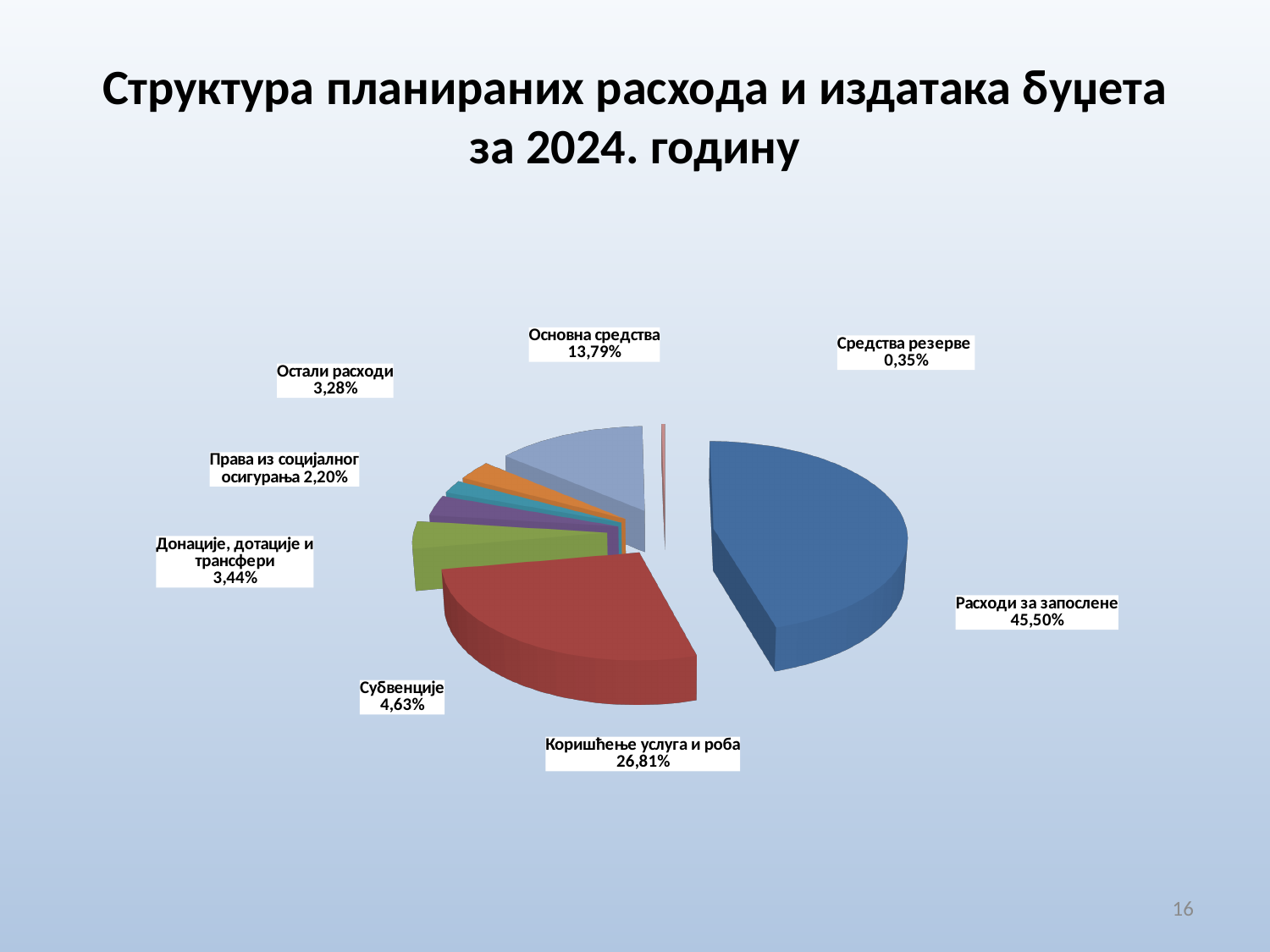
What percentage is shown for Субвенције? 4,63% What percentage is shown for Средства резерве? 0,35% What is the difference in percentage points between Расходи за запослене and Коришћење услуга и роба? 18,69 What percentage is shown for Основна средства? 13,79% What percentage is shown for Коришћење услуга и роба? 26,81% What is the title of the chart slide? Структура планираних расхода и издатака буџета за 2024. годину How many slices does the pie chart have? 8 Which is larger, Донације, дотације и трансфери or Остали расходи? Донације, дотације и трансфери What kind of chart is shown on the slide? pie chart Which category has the smallest slice of the pie? Средства резерве Which category has the largest slice of the pie? Расходи за запослене What share of the pie is labelled for Расходи за запослене? 45,50%